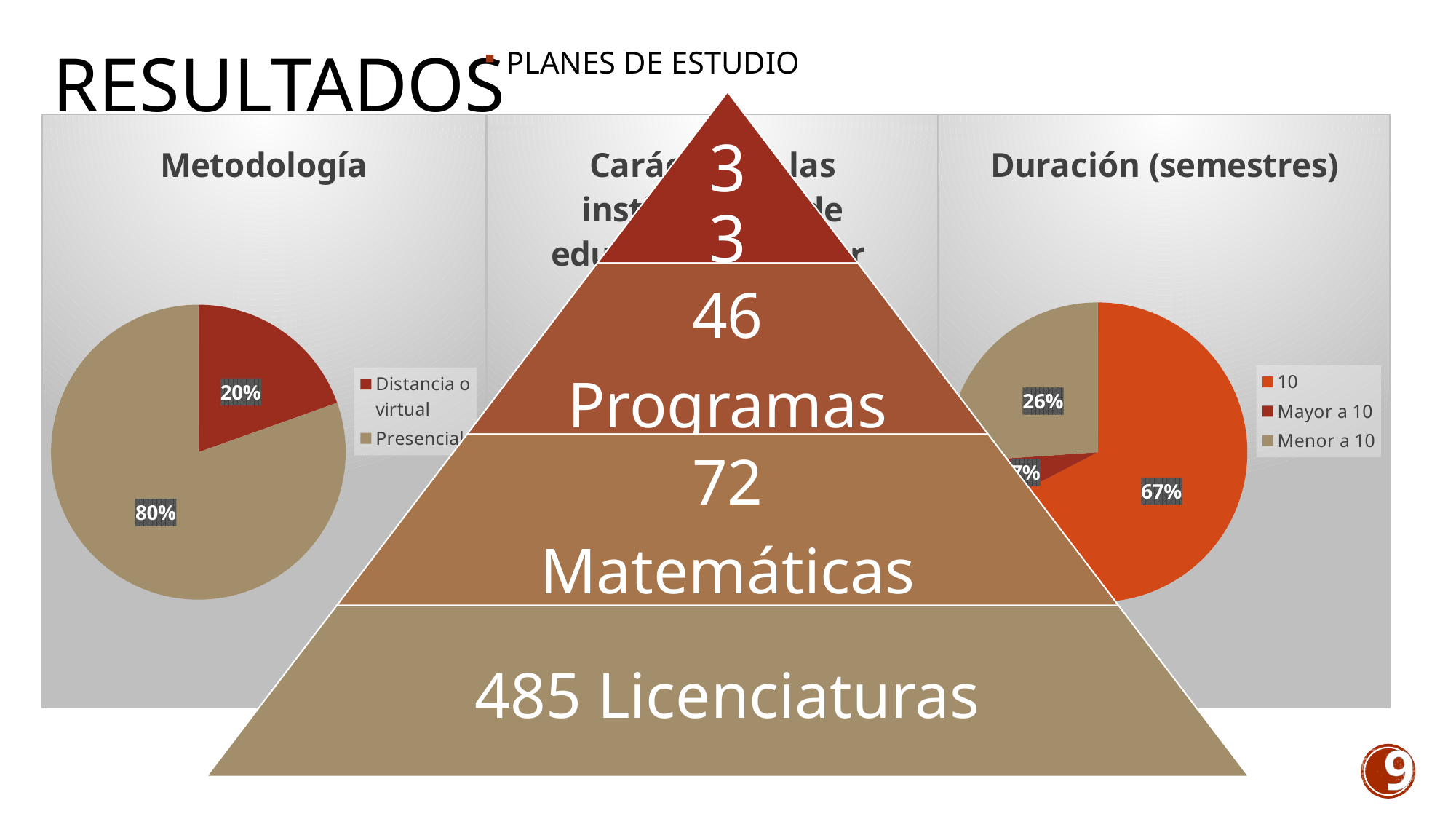
What kind of chart is the Metodología chart? Pie chart How many entries does the legend of the Duración (semestres) chart list? 3 In the Duración (semestres) chart, what percentage is shown for Menor a 10? 26% In the Duración (semestres) chart, what percentage is shown for 10? 67% In the Duración (semestres) chart, what is the difference in percentage points between 10 and Menor a 10? 41 percentage points In the Duración (semestres) chart, which category has the smallest share? Mayor a 10 In the Duración (semestres) chart, which category has the largest share? 10 How many entries does the legend of the Metodología chart list? 2 In the Metodología chart, which slice is larger, Presencial or Distancia o virtual? Presencial In the Metodología chart, what is the difference in percentage points between Presencial and Distancia o virtual? 60 percentage points In the Metodología chart, what percentage is shown for Distancia o virtual? 20% In the Metodología chart, what percentage is shown for Presencial? 80%